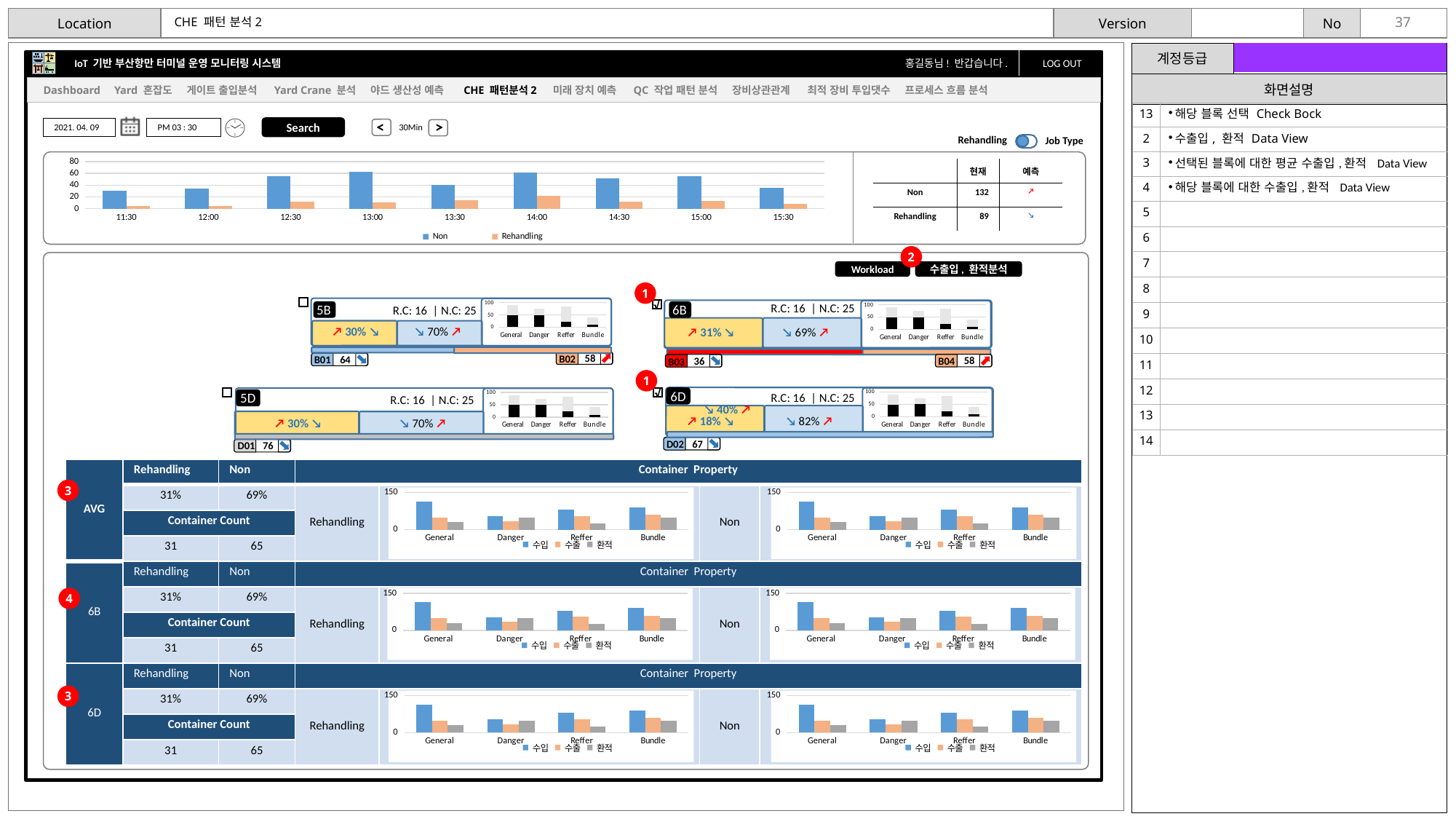
In the top bar chart (11:30 to 15:30), which is larger: the Non value at 12:30 or the Non value at 13:30? 12:30 How many series does the legend of the top bar chart (11:30 to 15:30) list? 2 In the top bar chart (11:30 to 15:30), at which time is the Rehandling bar the highest? 14:00 In the AVG row's Rehandling Container Property chart, which category has the tallest bar? General What kind of chart is the time-series chart at the top of the dashboard (11:30 to 15:30)? bar chart In the top bar chart (11:30 to 15:30), is the Non value at 13:00 greater or less than 40? greater How many series does the legend list in the AVG row's Rehandling Container Property chart? 3 How many time categories are shown on the x axis of the top bar chart (11:30 to 15:30)? 9 How many categories are shown on the x axis of the AVG row's Rehandling Container Property chart? 4 What are the two legend entries of the top bar chart (11:30 to 15:30)? Non, Rehandling In the top bar chart (11:30 to 15:30), is the Rehandling value at 11:30 greater or less than 20? less In the top bar chart (11:30 to 15:30), at which time is the Non bar the highest? 13:00